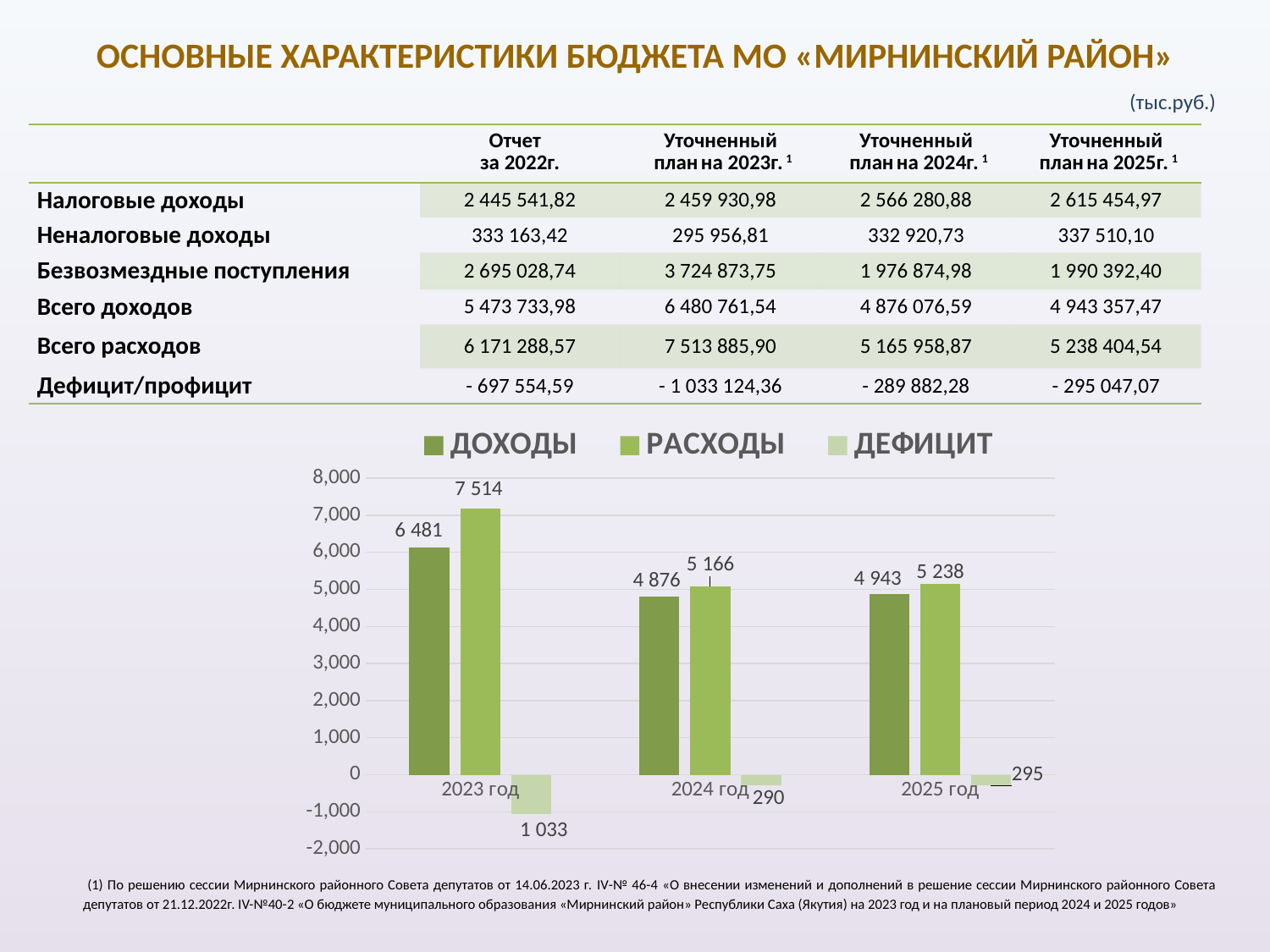
What is the value of ДОХОДЫ for 2023 год in the chart? 6 481 How many year categories are shown on the x axis of the chart? 3 How many series does the chart legend list? 3 What is the difference between РАСХОДЫ and ДОХОДЫ for 2023 год in the chart? 1 033 What is the value of РАСХОДЫ for 2024 год in the chart? 5 166 What is the value of РАСХОДЫ for 2025 год in the chart? 5 238 In which year is the ДОХОДЫ bar lowest in the chart? 2024 год In which year is the РАСХОДЫ bar highest in the chart? 2023 год Do the ДОХОДЫ values rise or fall from 2023 год to 2024 год in the chart? fall Which is larger in the chart for 2025 год: ДОХОДЫ or РАСХОДЫ? РАСХОДЫ What is the data label on the ДЕФИЦИТ bar for 2023 год? 1 033 What type of chart is shown on the slide? bar chart